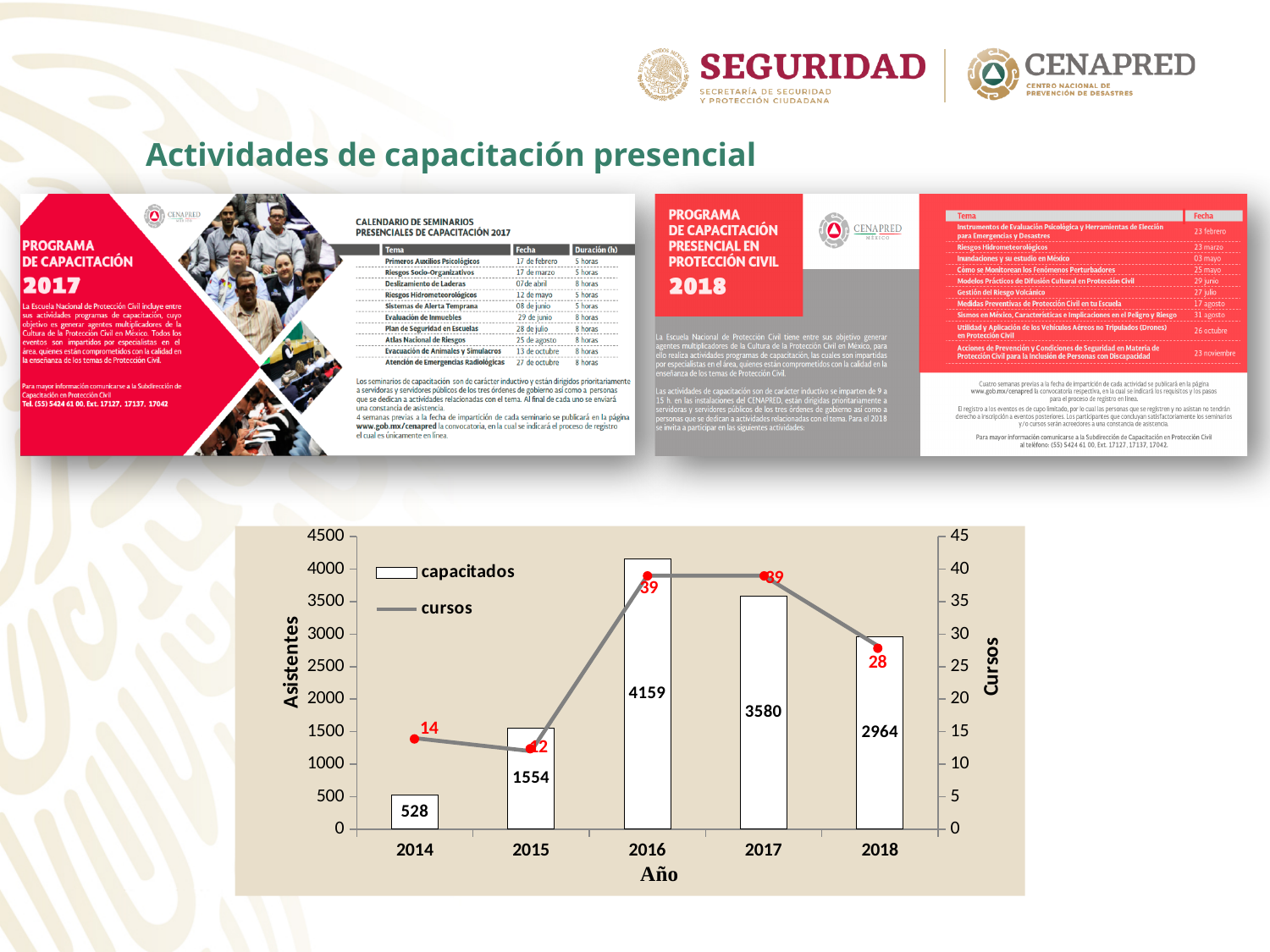
What is the value of capacitados for 2016? 4159 How many years are shown on the x axis? 5 How many series does the legend list? 2 Which year has the highest number of capacitados? 2016 What is the value of capacitados for 2014? 528 What is the difference in capacitados between 2016 and 2017? 579 What is the label of the right-hand vertical axis? Cursos What kind of chart is used to show capacitados? bar chart How many cursos were held in 2018? 28 Which year had more capacitados, 2015 or 2018? 2018 Which year has the lowest number of cursos? 2015 Do the capacitados values rise or fall from 2016 to 2018? fall